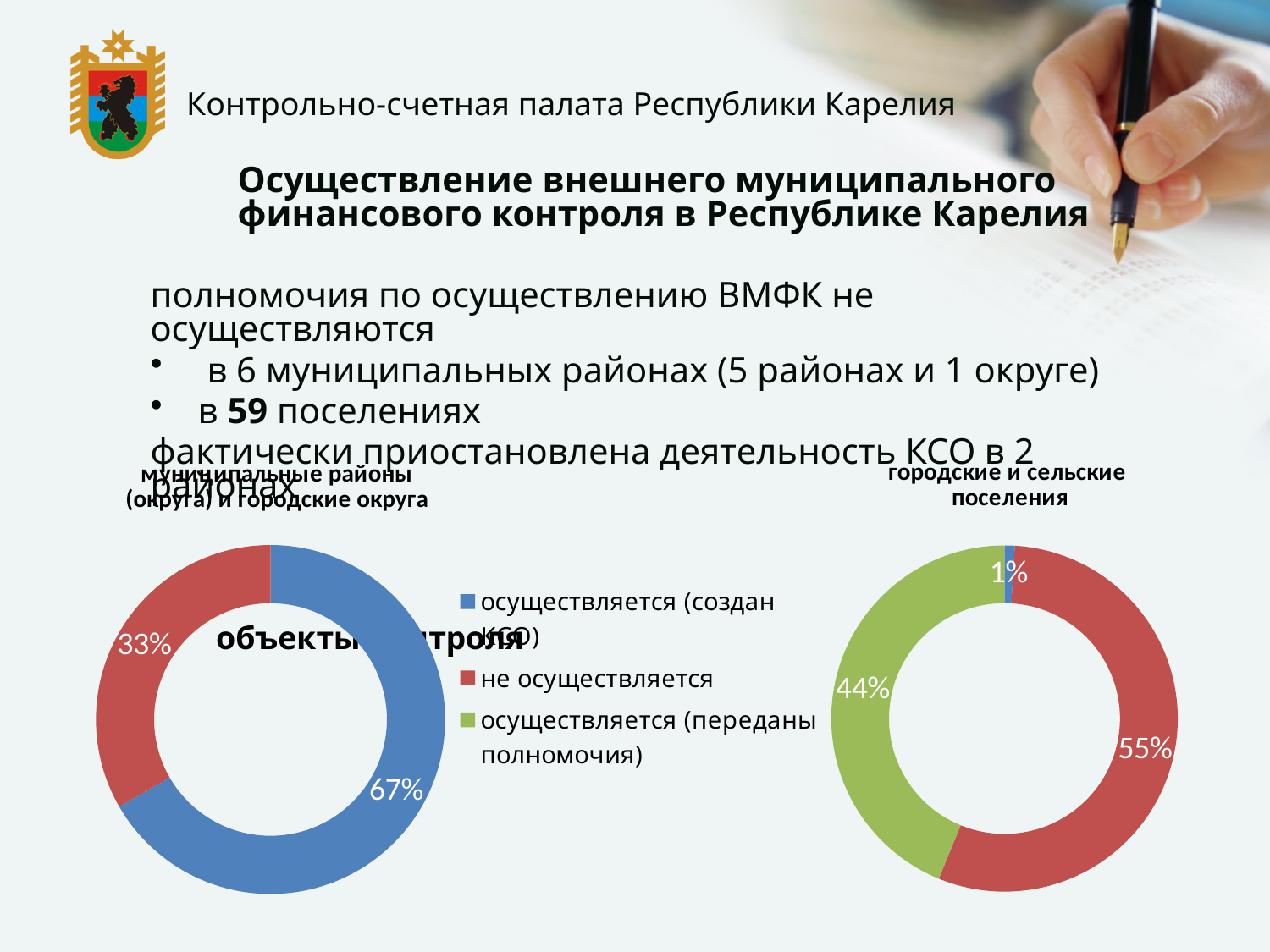
How many entries does the shared legend between the two doughnut charts list? 3 In the 'городские и сельские поселения' chart, what share is labelled 'не осуществляется'? 55% In the 'муниципальные районы (округа) и городские округа' chart, which category has the largest share? осуществляется (создан КСО) In the 'городские и сельские поселения' chart, what share is labelled 'осуществляется (переданы полномочия)'? 44% What colour represents 'не осуществляется' in the doughnut charts? red Which is larger: the 'не осуществляется' share in the 'муниципальные районы (округа) и городские округа' chart or in the 'городские и сельские поселения' chart? городские и сельские поселения In the 'городские и сельские поселения' chart, what is the difference between the 'не осуществляется' share and the 'осуществляется (переданы полномочия)' share? 11% In the 'муниципальные районы (округа) и городские округа' chart, what share is labelled 'не осуществляется'? 33% What kind of chart is used for 'муниципальные районы (округа) и городские округа'? doughnut chart In the 'муниципальные районы (округа) и городские округа' chart, what share is labelled 'осуществляется (создан КСО)'? 67% In the 'городские и сельские поселения' chart, which category has the smallest share? осуществляется (создан КСО) In the 'городские и сельские поселения' chart, what share is labelled 'осуществляется (создан КСО)'? 1%